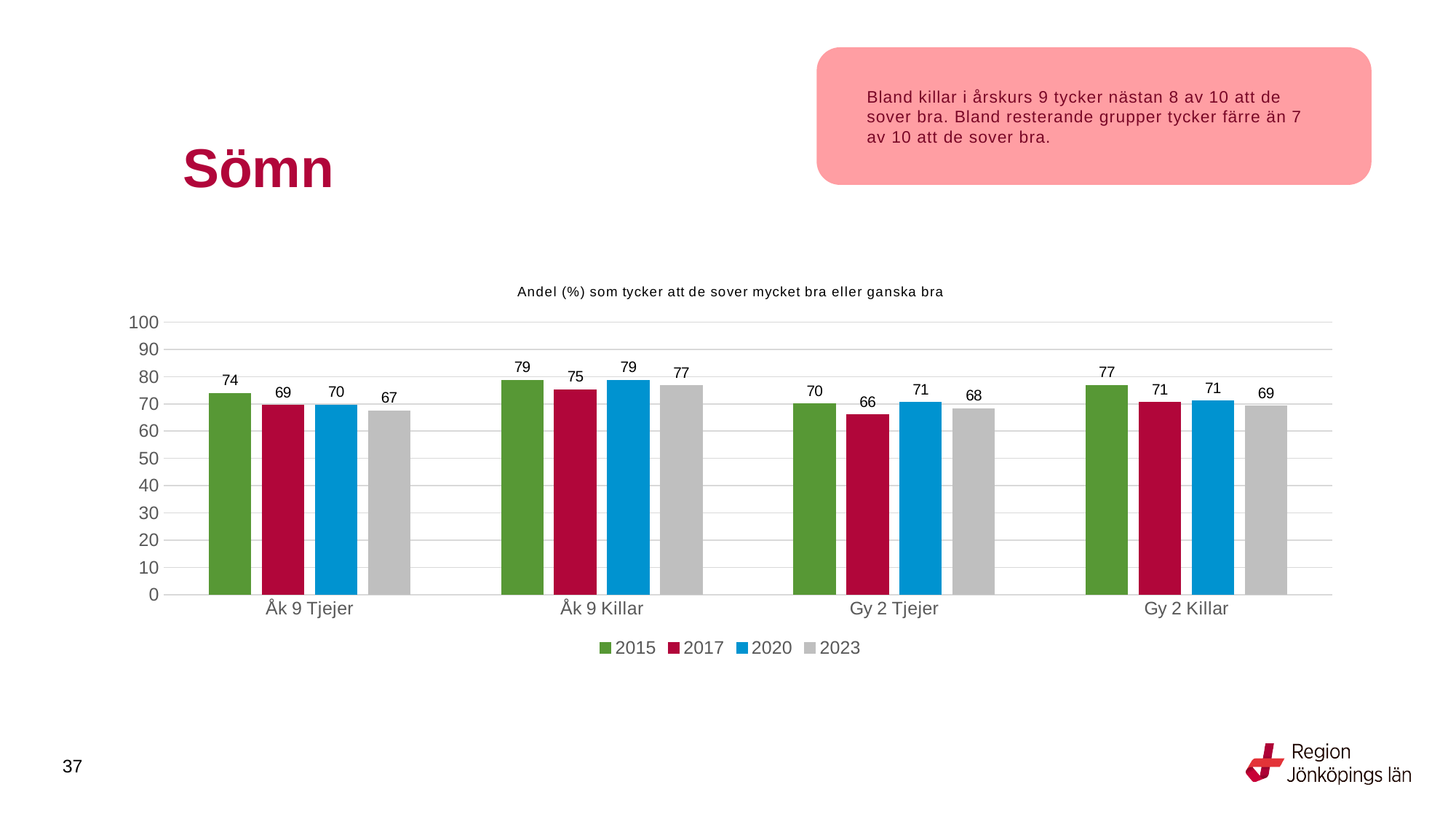
What is the difference between the 2015 and 2023 values for Gy 2 Killar? 8 How many series does the legend list? 4 Is the value for Åk 9 Killar in 2015 greater or less than 70? greater What is the value for Åk 9 Killar in 2023? 77 How many categories are shown on the x axis? 4 What is the value for Åk 9 Tjejer in 2015? 74 Which is larger for Gy 2 Tjejer: the 2015 value or the 2017 value? 2015 What is the value for Gy 2 Tjejer in 2017? 66 What is the title of the chart? Andel (%) som tycker att de sover mycket bra eller ganska bra Which category has the lowest value in 2023? Åk 9 Tjejer Which category has the highest value in 2020? Åk 9 Killar What kind of chart is shown on the slide? Bar chart